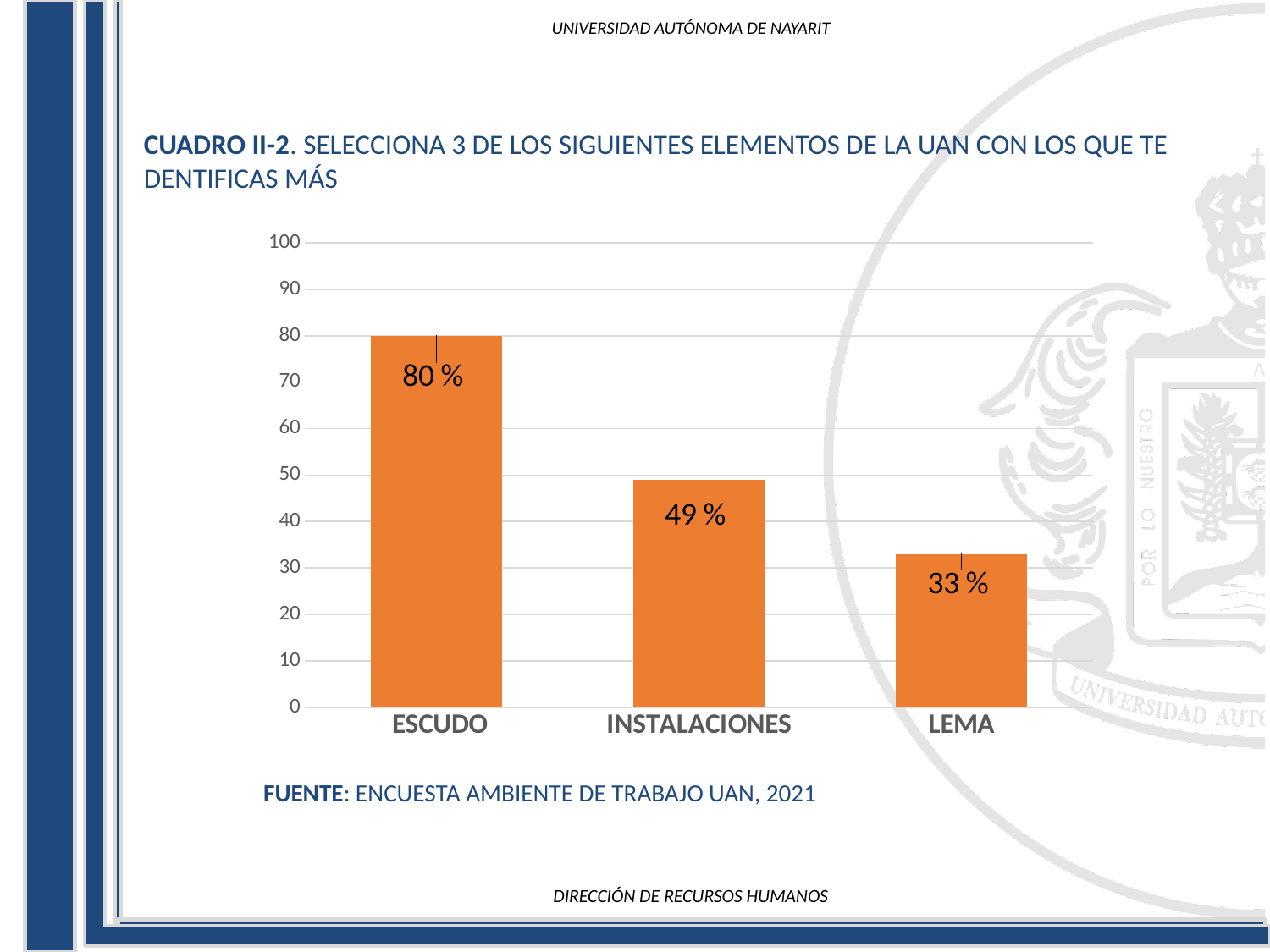
How many categories are shown in the chart? 3 What is the difference between the values for ESCUDO and INSTALACIONES? 31 % What is the difference between the values for INSTALACIONES and LEMA? 16 % What is the value for INSTALACIONES? 49 % What is the value for ESCUDO? 80 % What kind of chart is shown on the slide? bar chart Which category has the highest value? ESCUDO Which is larger, the value for INSTALACIONES or the value for LEMA? INSTALACIONES Which category has the lowest value? LEMA Is the value for INSTALACIONES greater or less than 50? less What is the value for LEMA? 33 % What is the source cited below the chart? ENCUESTA AMBIENTE DE TRABAJO UAN, 2021